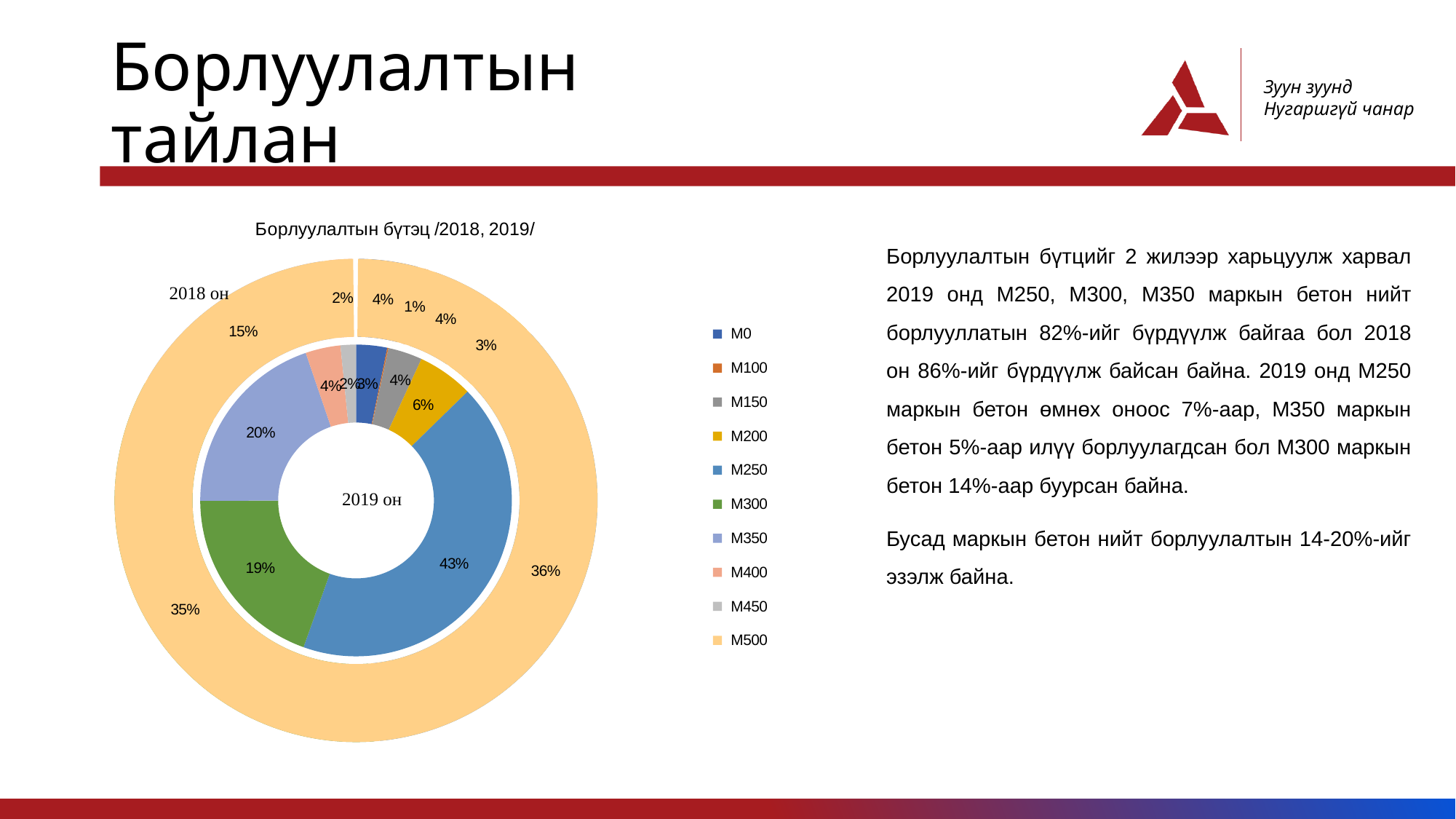
In the 2019 (inner) ring, which is larger: M350 or M300? M350 What share does M300 have in the 2019 (inner) ring? 19% Which year does the inner ring of the doughnut chart represent? 2019 он What is the largest share shown in the 2018 (outer) ring? 36% What share does M200 have in the 2019 (inner) ring? 6% How many entries does the chart legend list? 10 What share does M250 have in the 2019 (inner) ring? 43% In the 2019 (inner) ring, what is the difference between the shares of M250 and M300? 24% What kind of chart is shown on the slide? Doughnut chart What share does M350 have in the 2019 (inner) ring? 20% What is the title of the chart? Борлуулалтын бүтэц /2018, 2019/ Which grade has the largest share in the 2019 (inner) ring? M250